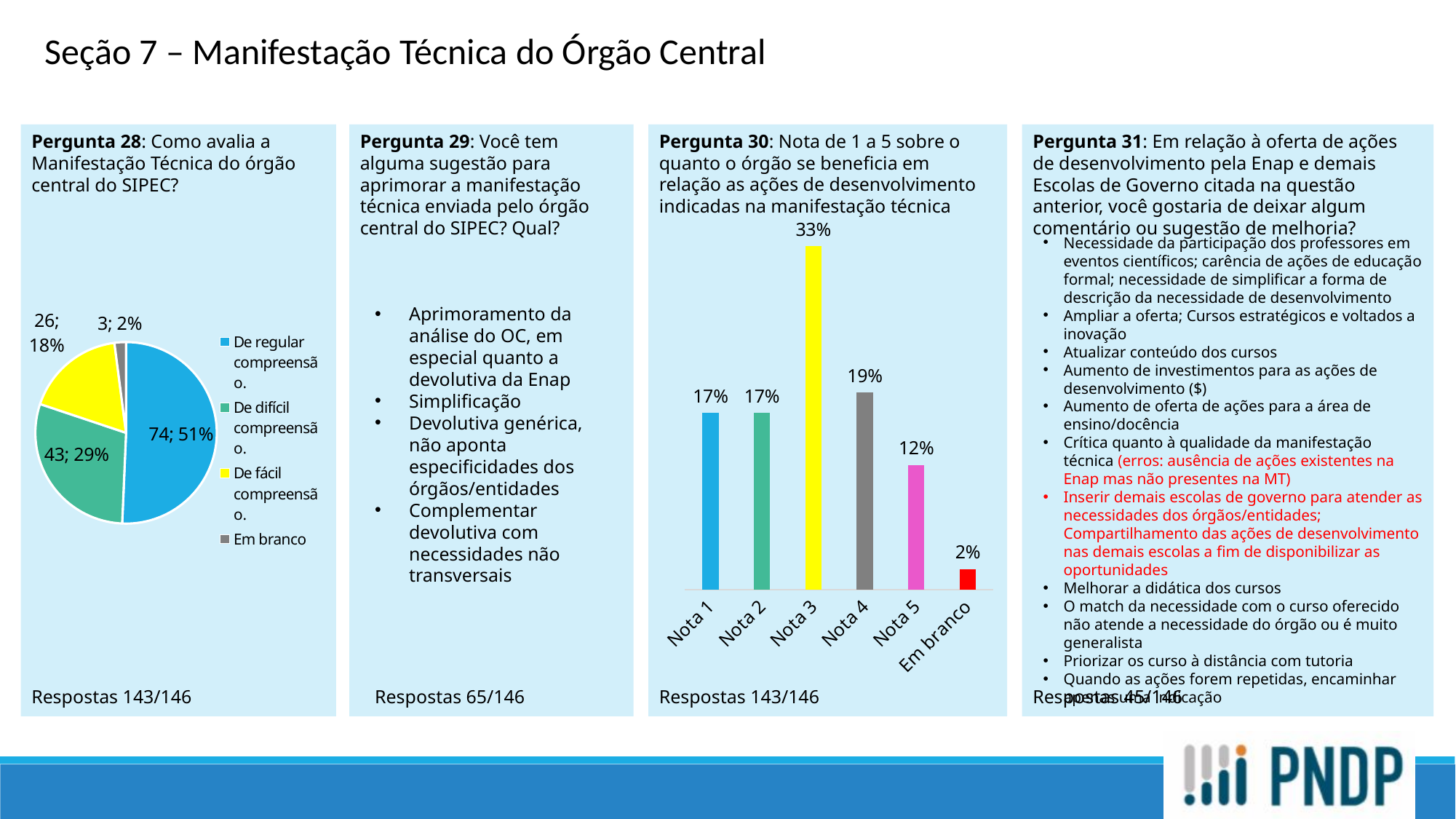
In the Pergunta 30 bar chart, which category has the lowest value? Em branco In the Pergunta 30 bar chart, how many bars are plotted? 6 What type of chart is shown under Pergunta 28? Pie chart In the Pergunta 28 pie chart, which category has the smallest slice? Em branco In the Pergunta 28 pie chart, what is the difference in count between 'De regular compreensão' and 'De difícil compreensão'? 31 What type of chart is shown under Pergunta 30? Bar chart In the Pergunta 30 bar chart, what is the value for Nota 3? 33% In the Pergunta 28 pie chart, what value is shown for 'De regular compreensão'? 74; 51% In the Pergunta 28 pie chart, how many categories does the legend list? 4 In the Pergunta 30 bar chart, which category has the highest value? Nota 3 In the Pergunta 28 pie chart, what percentage share does 'De difícil compreensão' have? 29% In the Pergunta 30 bar chart, what is the difference between Nota 4 and Nota 5? 7%